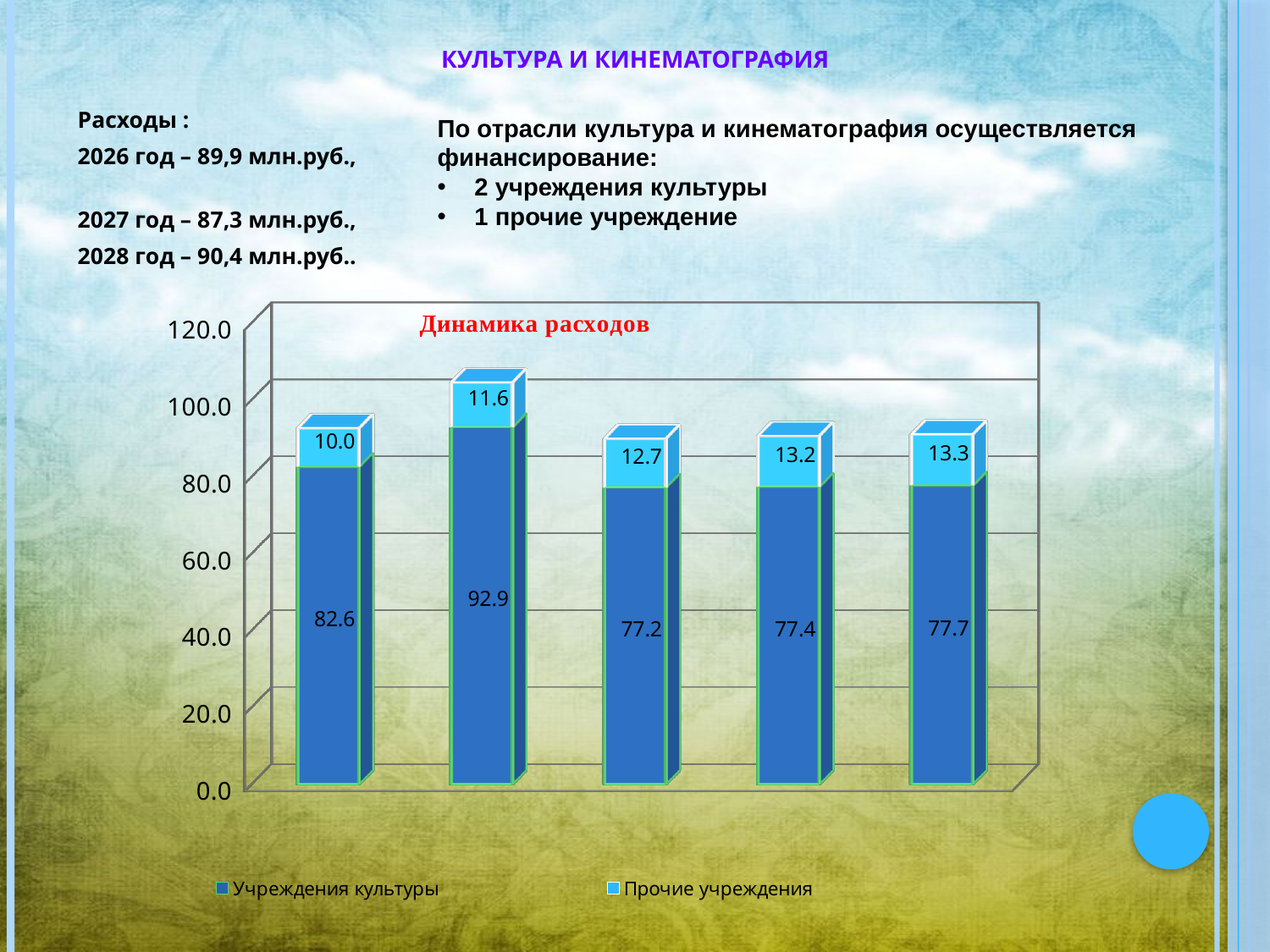
How many stacked bars are plotted in the chart? 5 How many series does the chart legend list? 2 Is the 'Учреждения культуры' value for the second bar from the left greater or less than 100.0? less What is the difference between the 'Учреждения культуры' values of the second and first bars from the left? 10.3 What is the total of the stacked second bar from the left? 104.5 What is the value of the 'Прочие учреждения' series for the first bar from the left? 10.0 What is the value of the 'Учреждения культуры' series for the second bar from the left? 92.9 Which bar has the highest value for the 'Учреждения культуры' series? the second bar from the left What is the title of the chart? Динамика расходов What is the value of the 'Прочие учреждения' series for the rightmost bar? 13.3 Which bar has the lowest value for the 'Прочие учреждения' series? the first bar from the left What type of chart is shown on the slide? bar chart